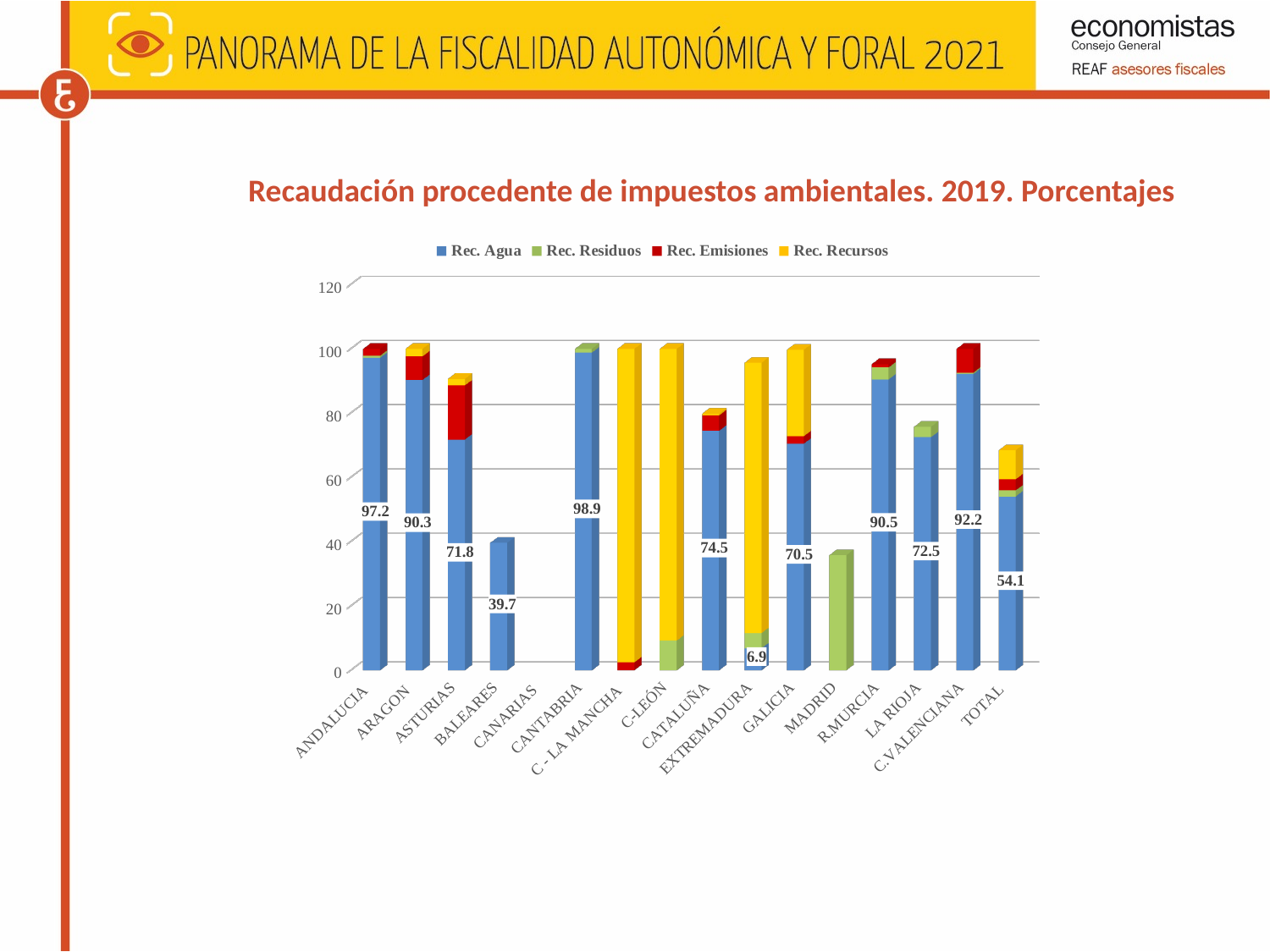
How many series does the legend list? 4 What is the Rec. Agua value for ANDALUCIA? 97.2 Which has a larger Rec. Agua value, ASTURIAS or LA RIOJA? LA RIOJA What kind of chart is shown on the slide? Stacked bar chart Which series is shown in yellow in the legend? Rec. Recursos How many categories are shown on the x axis? 16 What is the Rec. Agua value for EXTREMADURA? 6.9 Which category has the highest labelled Rec. Agua value? CANTABRIA What is the difference between the Rec. Agua values for ANDALUCIA and ARAGON? 6.9 Is the Rec. Recursos value for C - LA MANCHA greater or less than 80? greater What is the Rec. Agua value for TOTAL? 54.1 Which category has the lowest labelled Rec. Agua value? EXTREMADURA